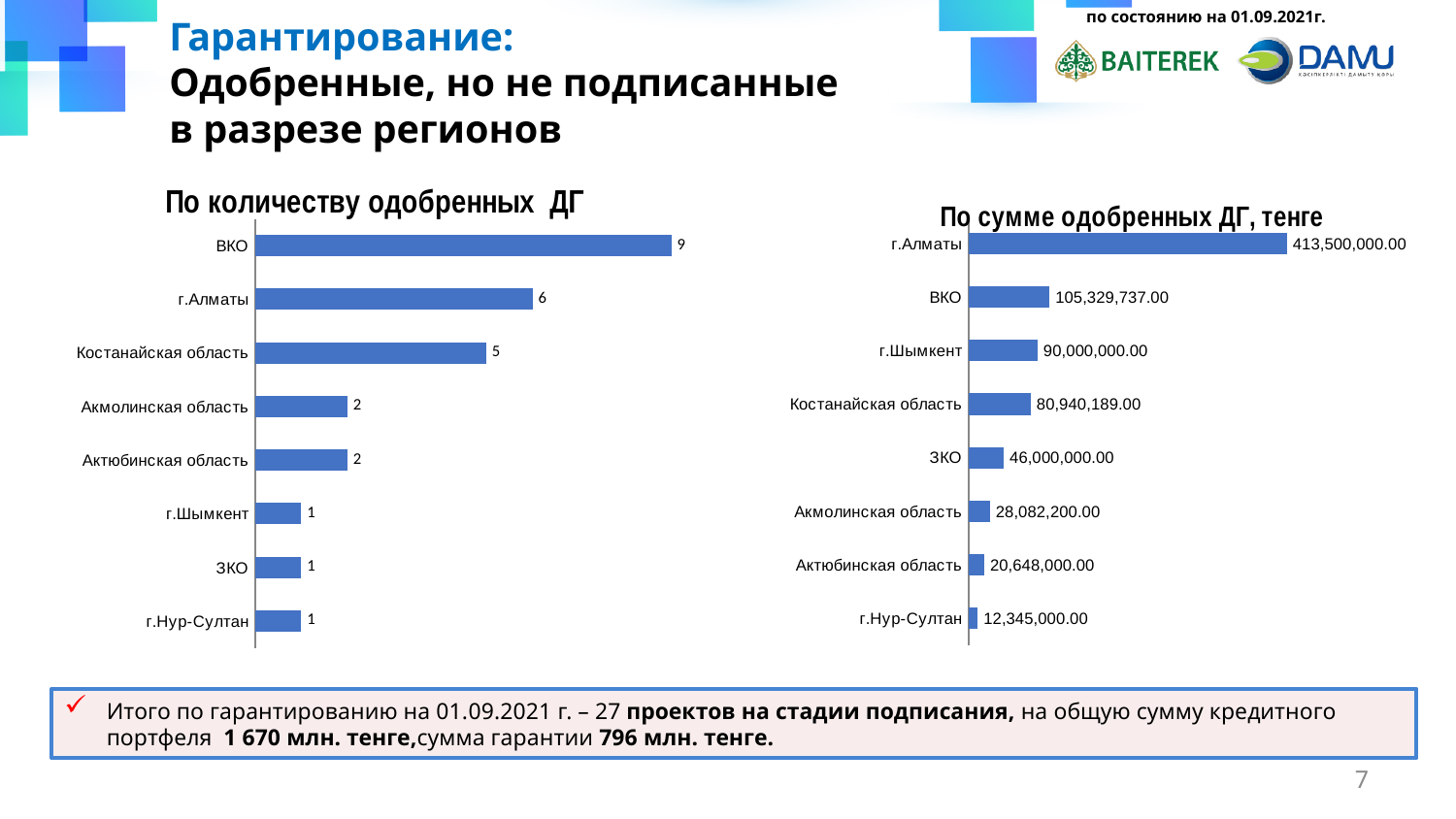
In the chart 'По сумме одобренных ДГ, тенге', which is larger: ВКО or г.Шымкент? ВКО In the chart 'По сумме одобренных ДГ, тенге', what is the difference between ЗКО and Акмолинская область? 17,917,800.00 In the chart 'По количеству одобренных ДГ', which region has the highest value? ВКО In the chart 'По сумме одобренных ДГ, тенге', which region has the lowest value? г.Нур-Султан In the chart 'По количеству одобренных ДГ', how many regions are shown? 8 What type of chart is 'По количеству одобренных ДГ'? Bar chart In the chart 'По количеству одобренных ДГ', what is the value for ВКО? 9 In the chart 'По количеству одобренных ДГ', what is the difference between ВКО and г.Алматы? 3 In the chart 'По сумме одобренных ДГ, тенге', what is the value for Костанайская область? 80,940,189.00 In the chart 'По сумме одобренных ДГ, тенге', what is the value for г.Алматы? 413,500,000.00 In the chart 'По количеству одобренных ДГ', what is the value for Костанайская область? 5 What is the title of the chart on the right side of the slide? По сумме одобренных ДГ, тенге